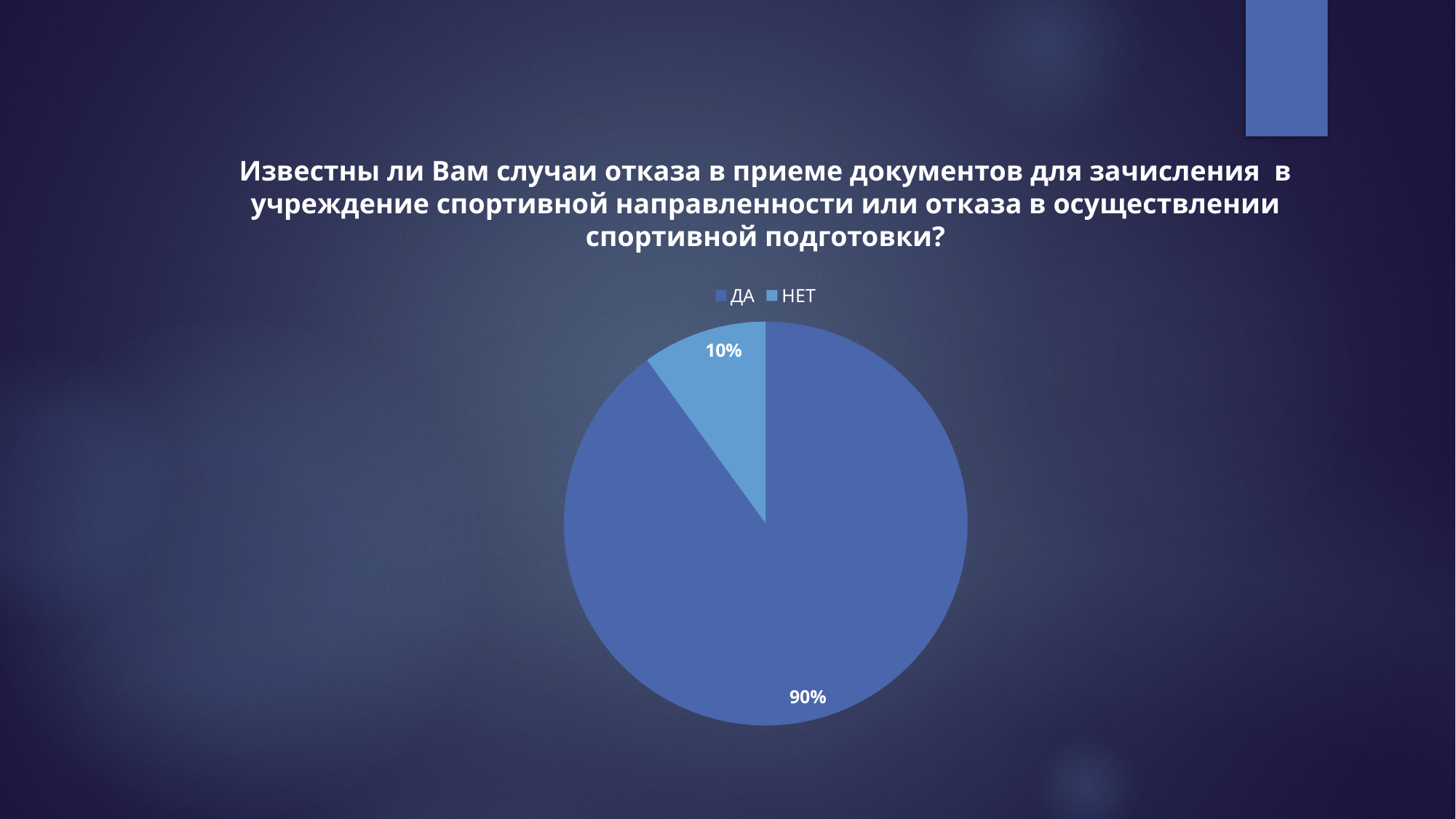
What share of the pie does НЕТ represent? 10% What is the combined share of the ДА and НЕТ slices? 100% What share of the pie does ДА represent? 90% What are the two legend entries of the chart? ДА and НЕТ Which category has the largest slice of the pie? ДА Which category has the smallest slice of the pie? НЕТ Which legend entry is shown in the lighter blue colour? НЕТ How many slices does the pie chart have? 2 How many entries does the legend list? 2 Which slice is larger, ДА or НЕТ? ДА What is the difference in percentage points between the ДА and НЕТ slices? 80 What kind of chart is shown on the slide? Pie chart